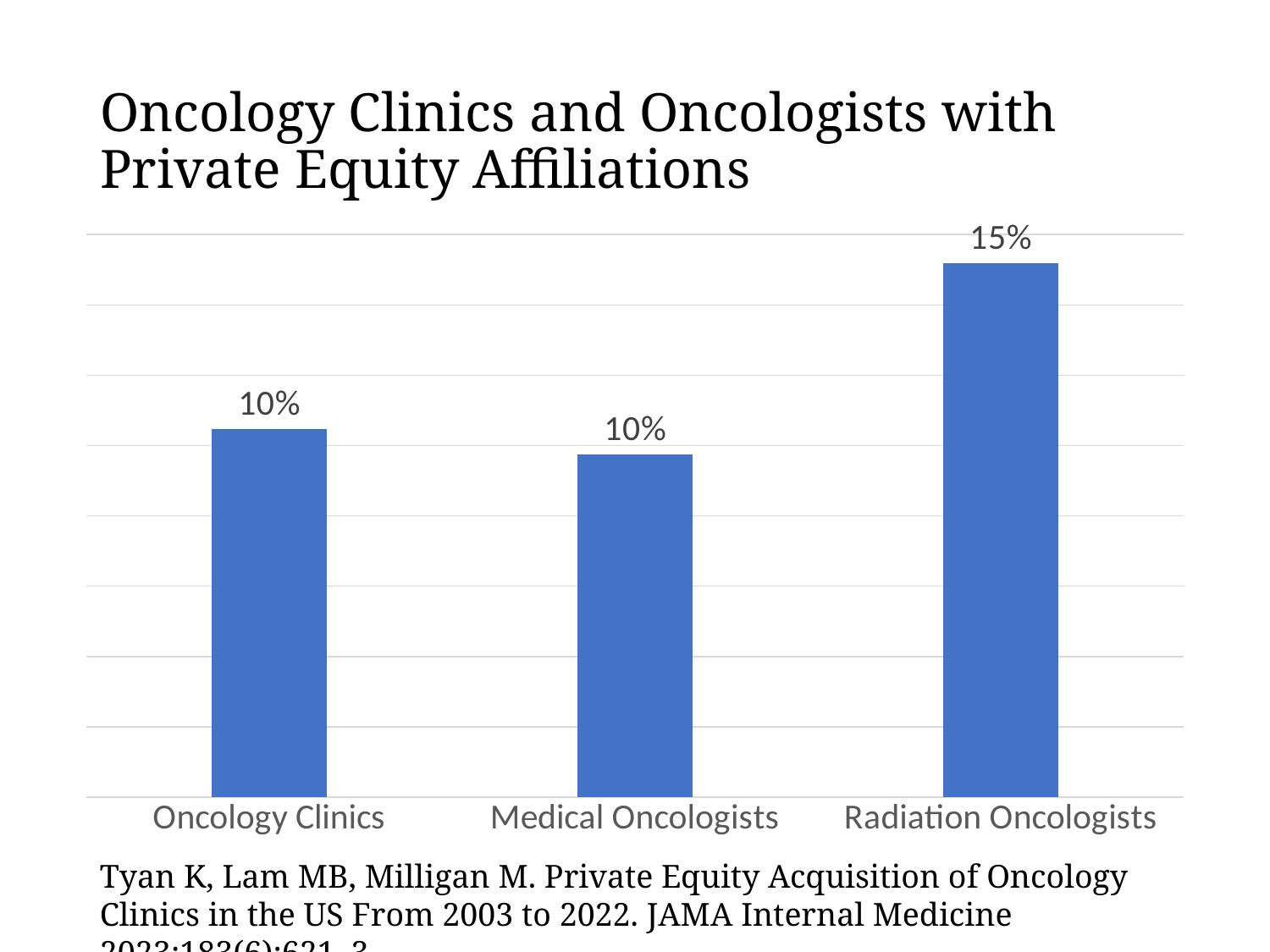
What is the title of the slide containing the chart? Oncology Clinics and Oncologists with Private Equity Affiliations How many categories are shown in the chart? 3 Which is larger, the value for Medical Oncologists or the value for Radiation Oncologists? Radiation Oncologists What is the value shown for Radiation Oncologists? 15% What is the value shown for Oncology Clinics? 10% Which is larger, the value for Radiation Oncologists or the value for Oncology Clinics? Radiation Oncologists What colour are the bars in the chart? Blue What is the difference between the values for Radiation Oncologists and Medical Oncologists? 5% What kind of chart is shown on the slide? Bar chart Which category has the highest value? Radiation Oncologists What is the difference between the values for Radiation Oncologists and Oncology Clinics? 5% What is the value shown for Medical Oncologists? 10%